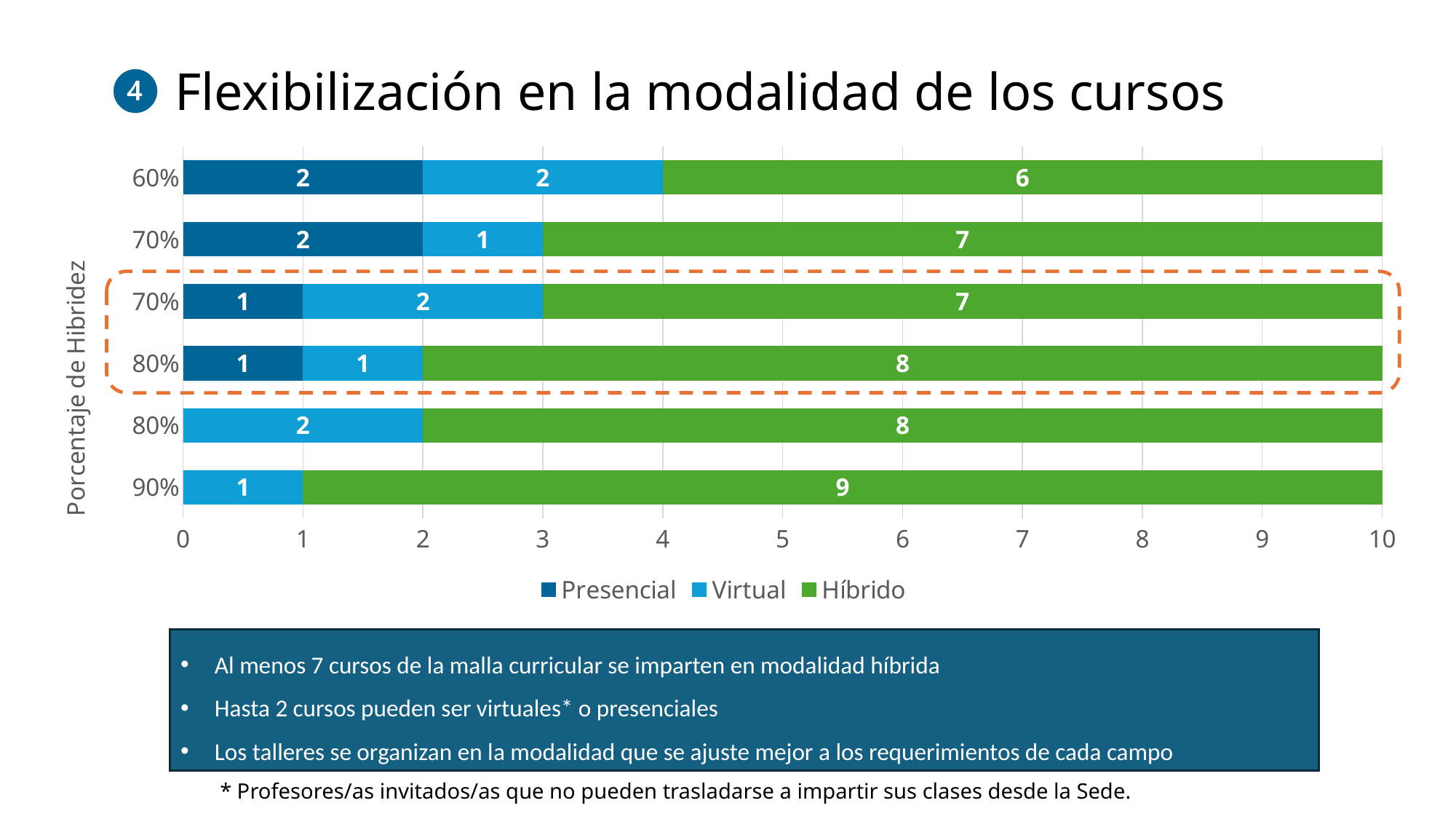
In the bar labelled 60%, which is larger: the Híbrido value or the Presencial value? Híbrido What is the Virtual value for the bottom bar labelled 90%? 1 What is the Presencial value for the 80% bar inside the dashed orange box? 1 What kind of chart is shown on the slide? bar chart How many bars are plotted in the chart? 6 What is the Híbrido value for the top bar labelled 60%? 6 How many series does the legend list? 3 Which bar has the lowest Híbrido value? 60% What is the total of the stacked bar labelled 60%? 10 What is the difference between the Híbrido value of the 90% bar and the Híbrido value of the 60% bar? 3 Which bar has the highest Híbrido value? 90% What are the three legend entries of the chart? Presencial, Virtual, Híbrido